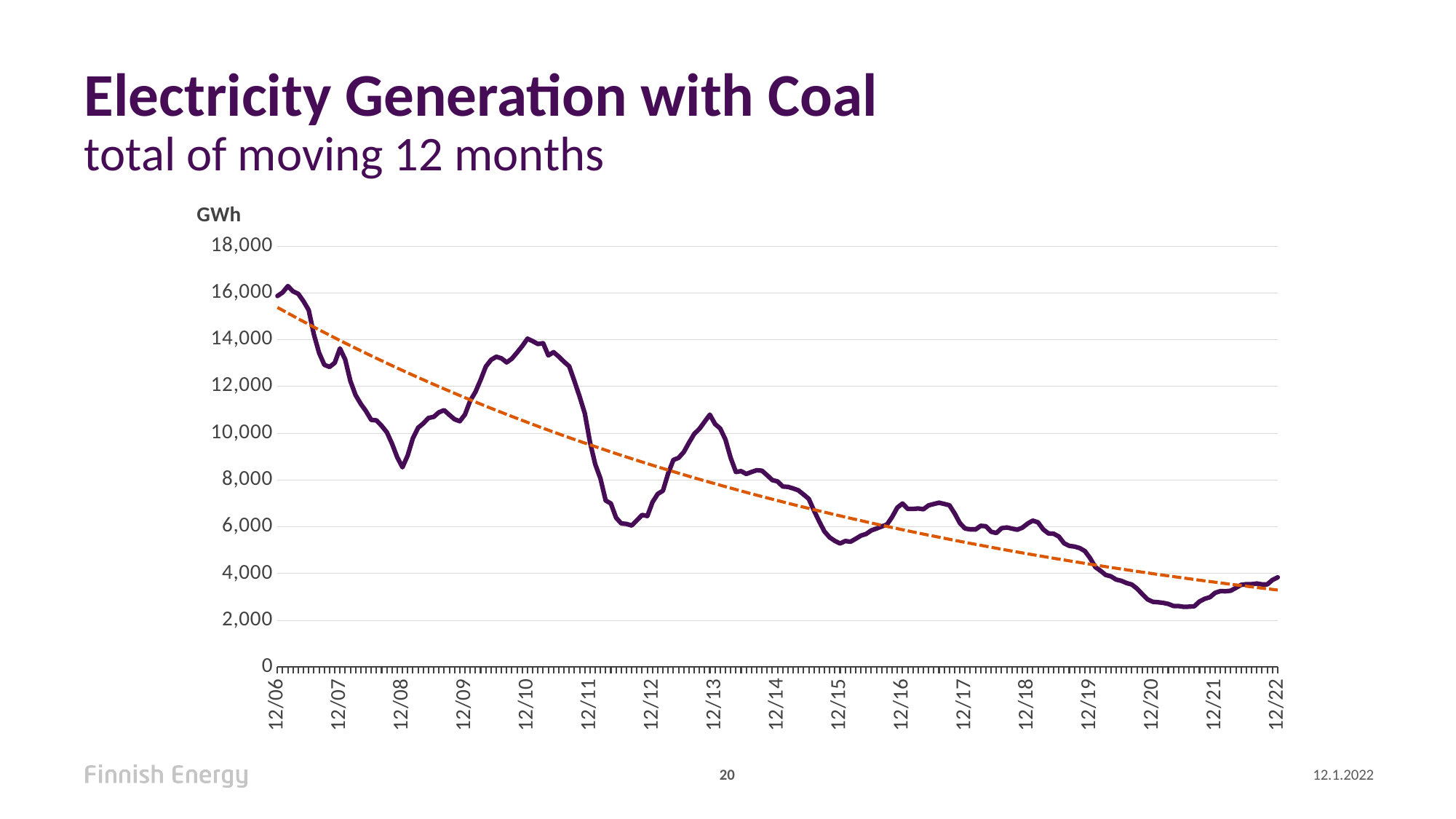
Is the value at 12/20 greater or less than 4,000? less Is the value at 12/15 greater or less than 6,000? less What kind of chart is shown on the slide? line chart How many labels are shown on the x axis? 17 Is the value at 12/22 greater or less than 6,000? less What unit is shown on the y axis? GWh Which of the labelled x-axis points has the highest value, 12/06 or 12/10? 12/06 Overall, do the values rise or fall from 12/06 to 12/22? fall